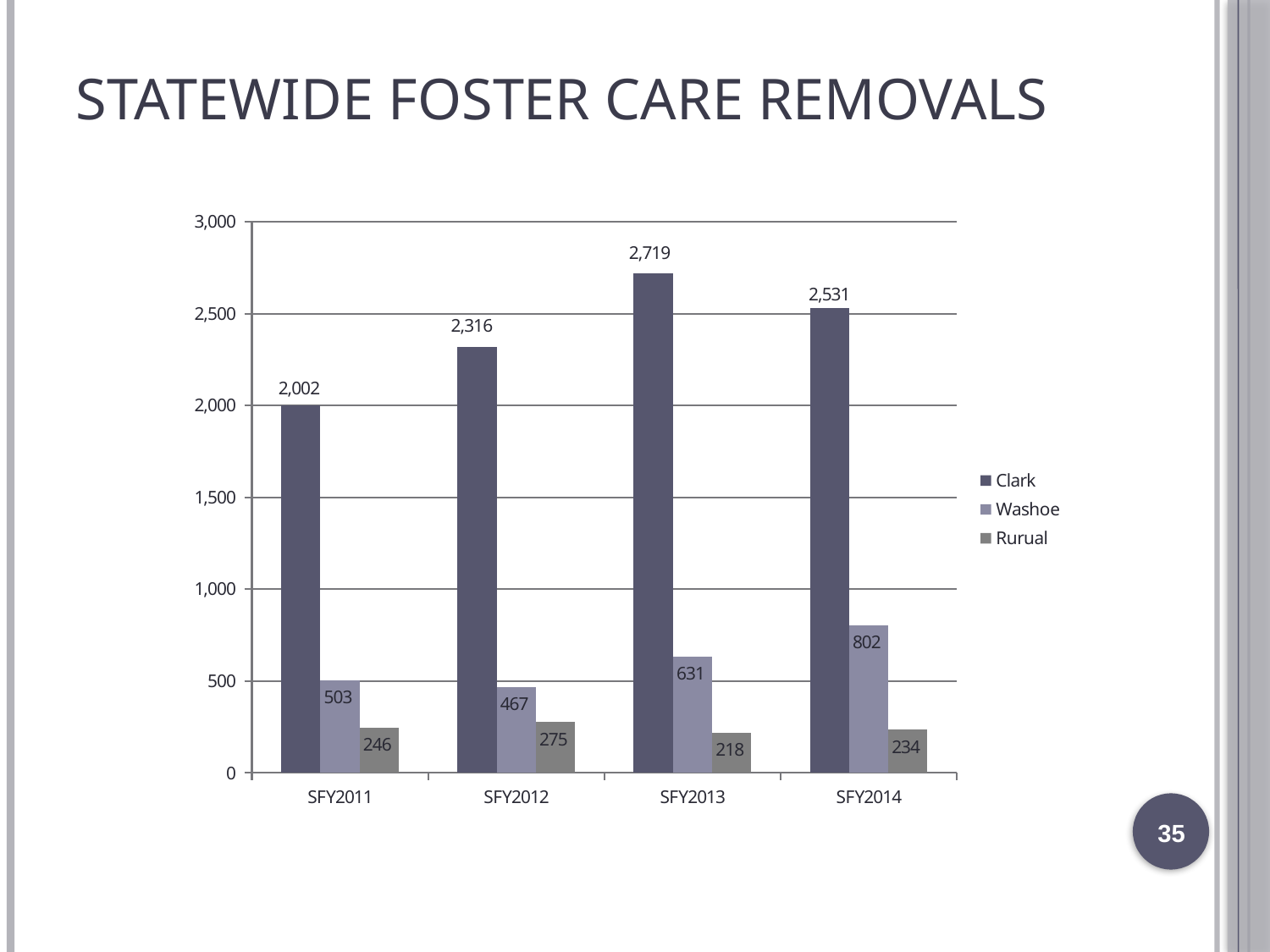
How many series does the legend list? 3 In which year is the Rurual value lowest? SFY2013 What is the value for Rurual in SFY2014? 234 What kind of chart is shown? bar chart Is the value for Washoe in SFY2014 greater or less than 1,000? less What is the title of the slide? Statewide Foster Care Removals What is the value for Washoe in SFY2012? 467 Which is larger, the Washoe value in SFY2011 or in SFY2012? SFY2011 What is the difference between the Clark values for SFY2013 and SFY2014? 188 In which year is the Clark value highest? SFY2013 How many years are shown on the x axis? 4 What is the value for Clark in SFY2013? 2,719